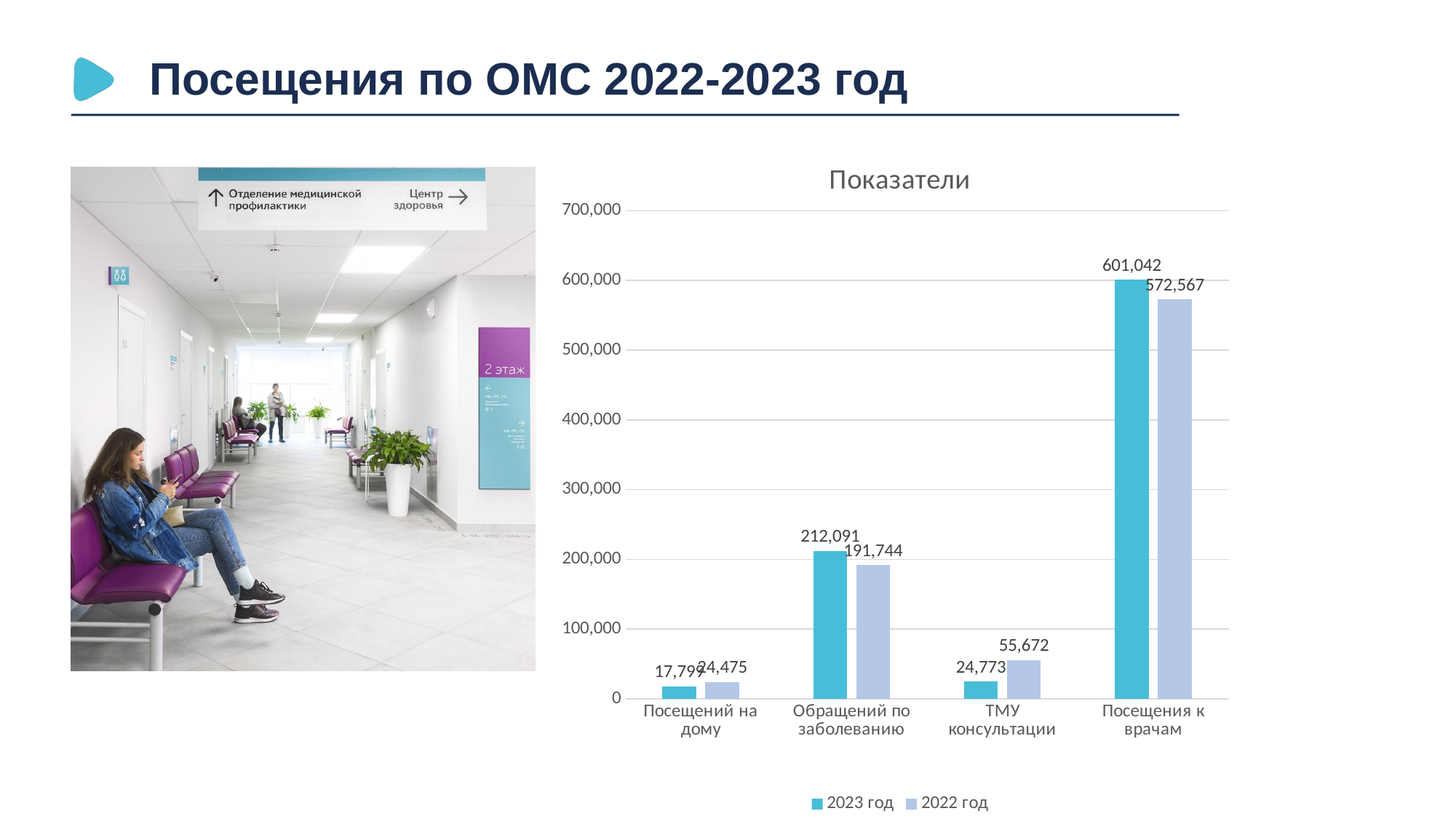
What is the difference between the 2023 год and 2022 год values for Посещения к врачам? 28,475 Which category has the highest value in the 2023 год series? Посещения к врачам What is the value for Посещения к врачам in the 2023 год series? 601,042 How many categories are shown on the x axis of the chart? 4 What is the difference between the 2022 год and 2023 год values for ТМУ консультации? 30,899 For Обращений по заболеванию, which series has the larger value, 2023 год or 2022 год? 2023 год What is the value for ТМУ консультации in the 2022 год series? 55,672 What is the value for Обращений по заболеванию in the 2023 год series? 212,091 Is the 2022 год value for Обращений по заболеванию greater or less than 100,000? greater What type of chart is shown on the slide? Bar chart What is the value for Посещения к врачам in the 2022 год series? 572,567 Which category has the lowest value in the 2022 год series? Посещений на дому